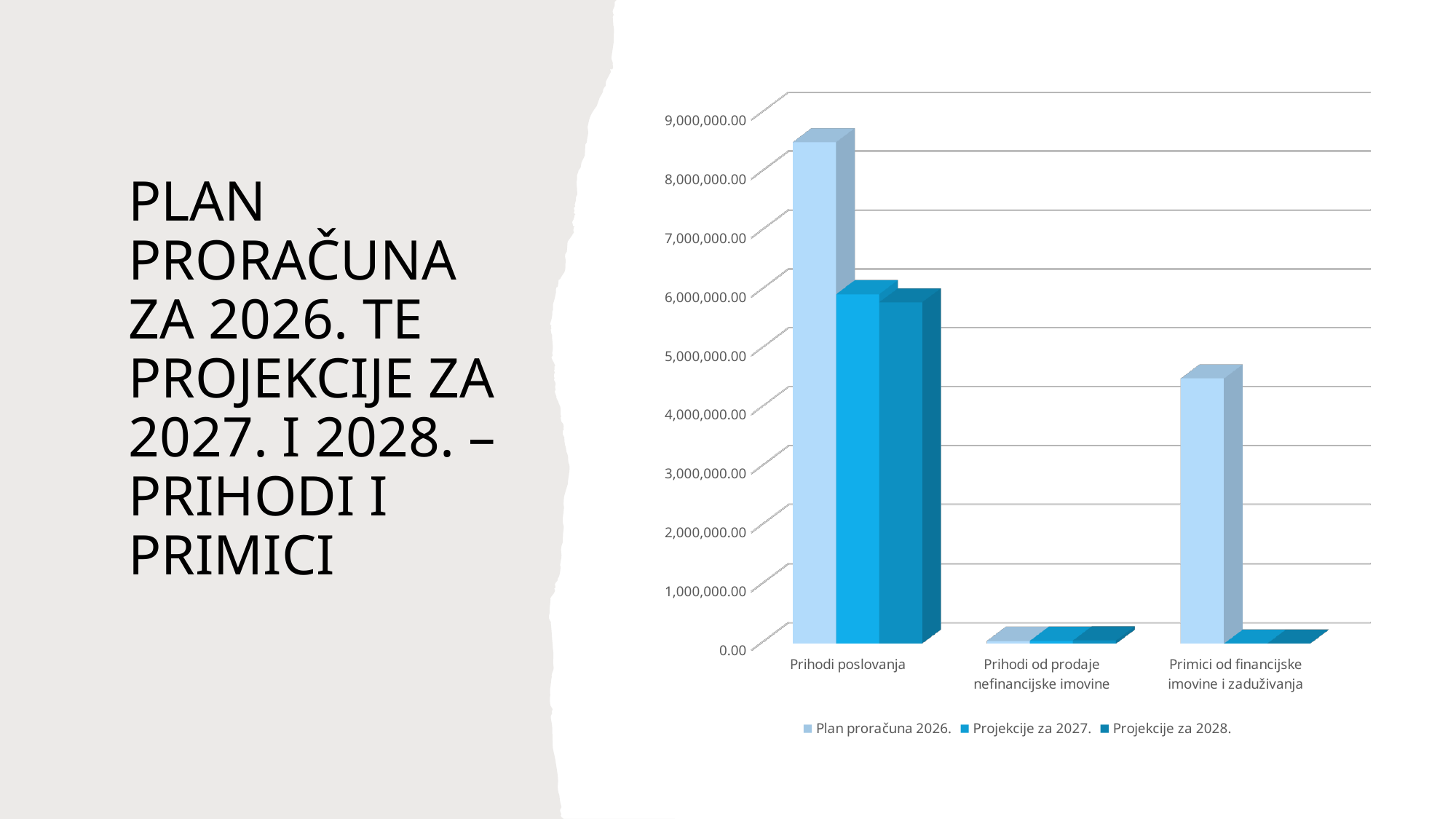
Is the value for Primici od financijske imovine i zaduživanja in Plan proračuna 2026. greater or less than 4,000,000.00? greater Is the value for Prihodi poslovanja in Projekcije za 2027. greater or less than 7,000,000.00? less How many series does the chart's legend list? 3 Which category has the lowest value for Plan proračuna 2026.? Prihodi od prodaje nefinancijske imovine What kind of chart is shown on the slide? bar chart For Primici od financijske imovine i zaduživanja, which series has the larger value: Plan proračuna 2026. or Projekcije za 2028.? Plan proračuna 2026. For Prihodi poslovanja, which series has the larger value: Plan proračuna 2026. or Projekcije za 2027.? Plan proračuna 2026. What are the three series listed in the chart's legend? Plan proračuna 2026., Projekcije za 2027., Projekcije za 2028. Which category has the highest value for Plan proračuna 2026.? Prihodi poslovanja How many categories are shown on the x axis of the chart? 3 Is the value for Prihodi poslovanja in Plan proračuna 2026. greater or less than 8,000,000.00? greater